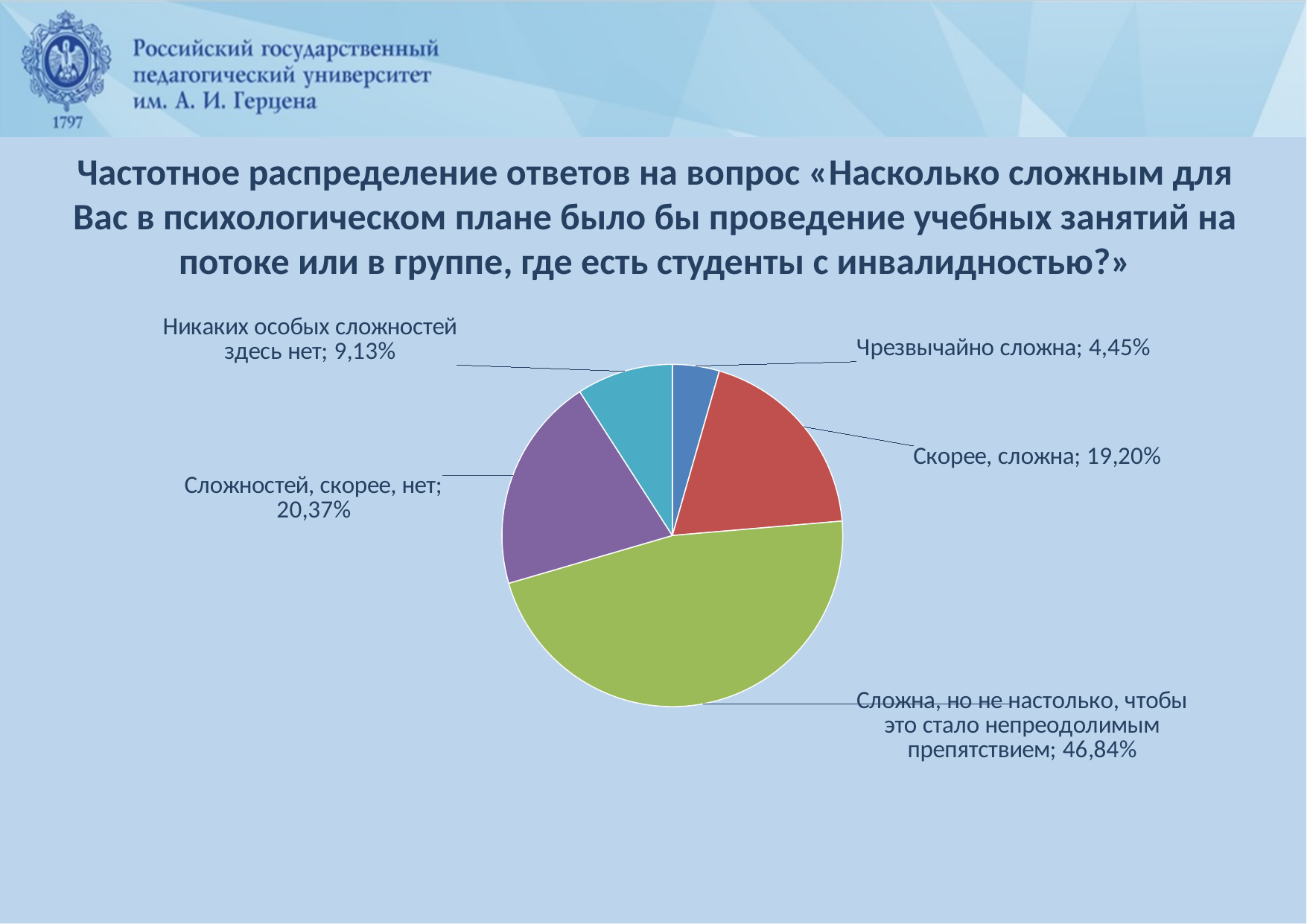
What is the difference between the shares for «Сложностей, скорее, нет» and «Скорее, сложна»? 1,17% What kind of chart is shown on the slide? pie chart What is the value for «Никаких особых сложностей здесь нет»? 9,13% What colour is the slice for «Сложна, но не настолько, чтобы это стало непреодолимым препятствием»? green Which is larger: the share for «Сложностей, скорее, нет» or the share for «Никаких особых сложностей здесь нет»? Сложностей, скорее, нет Which answer option has the smallest share of the pie? Чрезвычайно сложна What is the value for «Сложна, но не настолько, чтобы это стало непреодолимым препятствием»? 46,84% What is the value for «Сложностей, скорее, нет»? 20,37% What is the value for «Скорее, сложна»? 19,20% Which answer option has the largest share of the pie? Сложна, но не настолько, чтобы это стало непреодолимым препятствием How many slices does the pie chart have? 5 What is the value for «Чрезвычайно сложна»? 4,45%